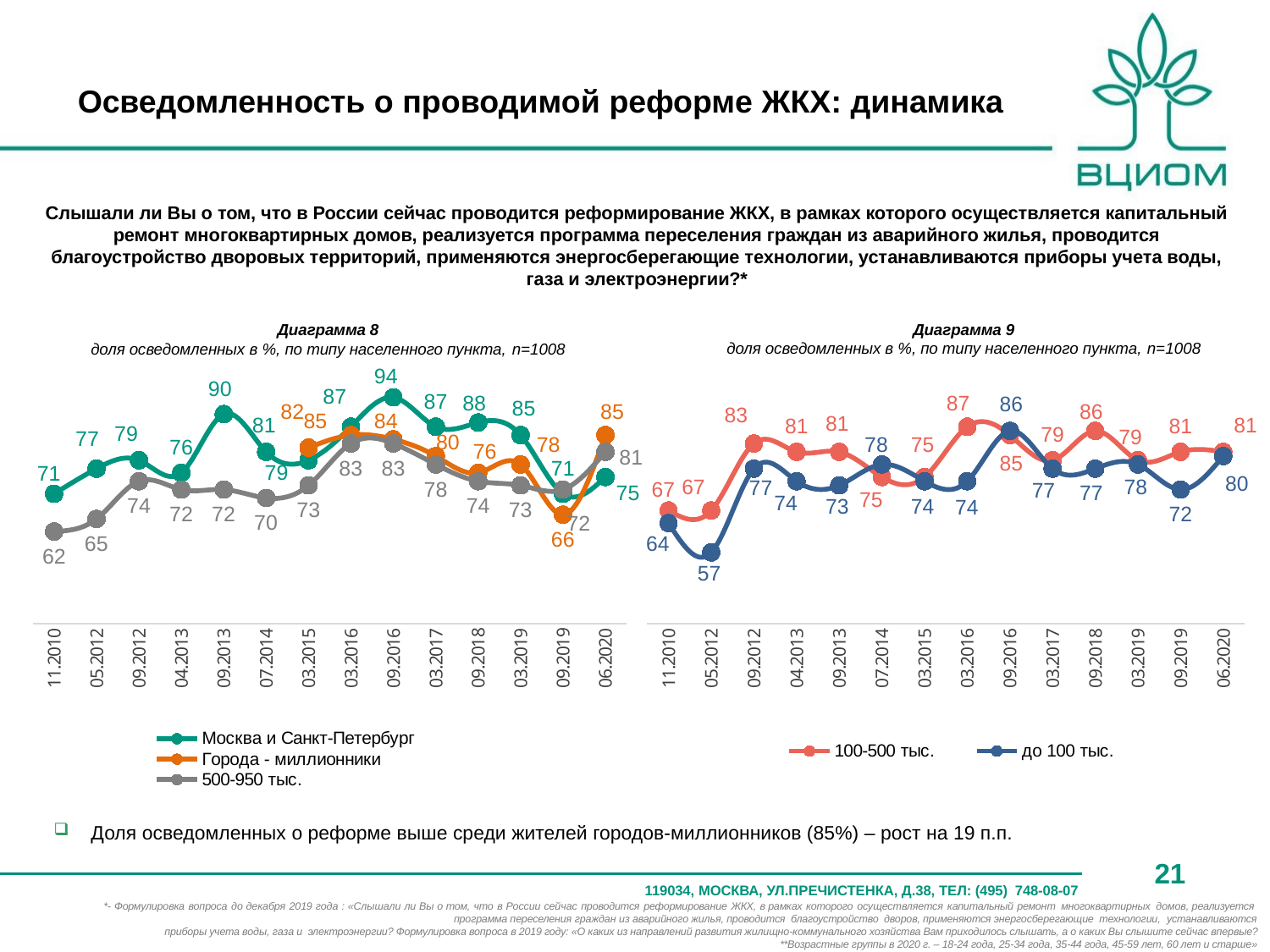
How many time points are shown on the x axis of Диаграмма 9 (right chart)? 14 In Диаграмма 8 (left chart), what is the value for Города - миллионники in 09.2019? 66 In Диаграмма 8 (left chart), what is the value for Москва и Санкт-Петербург in 09.2013? 90 How many series does the legend of Диаграмма 9 (right chart) list? 2 How many series does the legend of Диаграмма 8 (left chart) list? 3 What kind of chart is Диаграмма 8 on the left? Line chart In Диаграмма 8 (left chart), at which date does the Москва и Санкт-Петербург series reach its highest value? 09.2016 In Диаграмма 9 (right chart), what is the difference between the до 100 тыс. values in 06.2020 and 09.2019? 8 In Диаграмма 8 (left chart), what is the lowest value of the 500-950 тыс. series? 62 In Диаграмма 9 (right chart), what is the value for 100-500 тыс. in 09.2012? 83 In Диаграмма 9 (right chart), which series has the larger value in 05.2012: 100-500 тыс. or до 100 тыс.? 100-500 тыс. In Диаграмма 9 (right chart), what is the lowest value of the до 100 тыс. series? 57